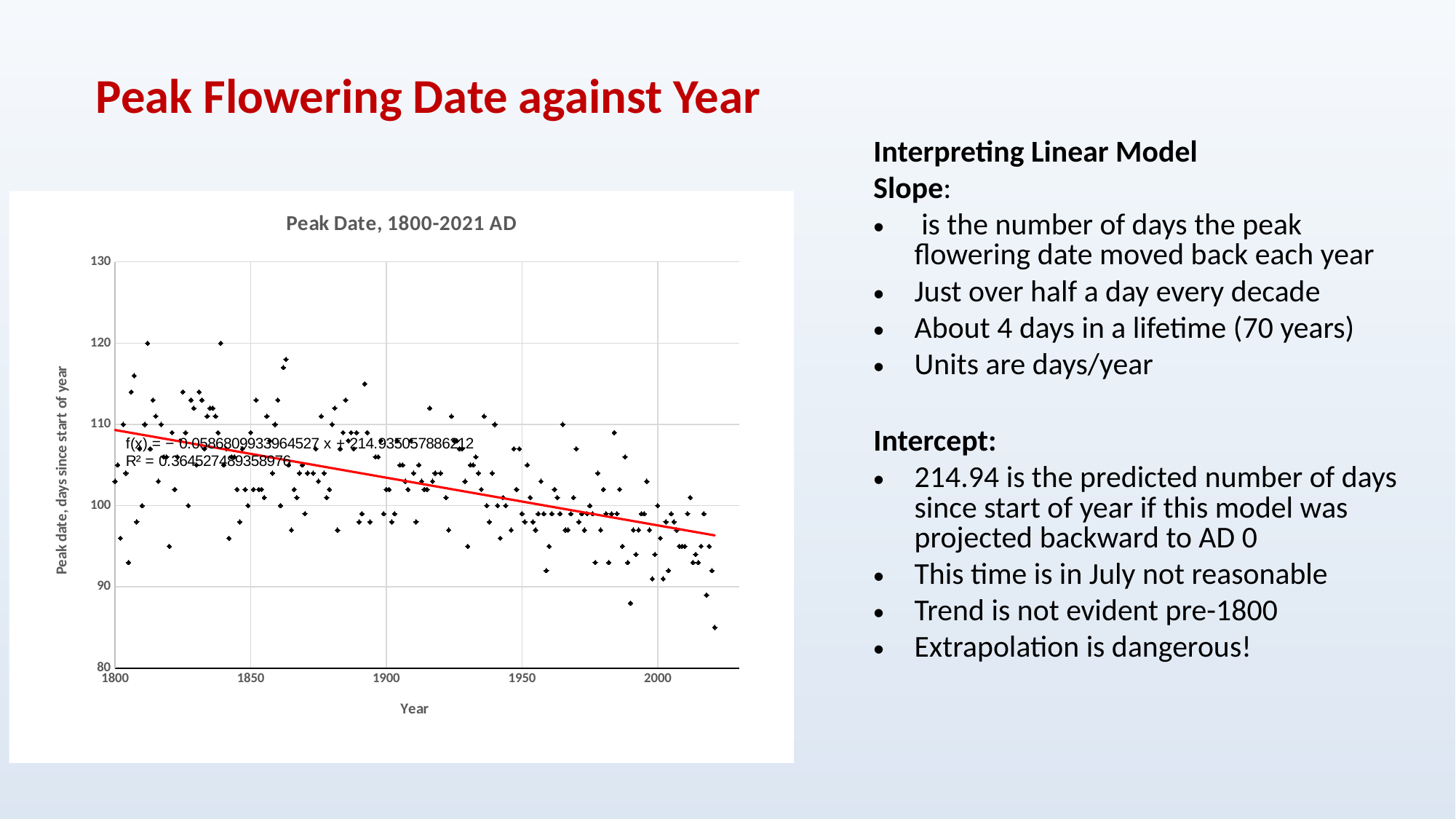
What is the title of the chart? Peak Date, 1800-2021 AD Is the fitted line's value at the year 1800 greater or less than 100 days? greater What is the slope of the fitted line f(x) printed on the chart? −0.0586809933964527 What is the intercept of the fitted line f(x) printed on the chart? 214.935057886212 What kind of chart is shown on the slide? Scatter chart Is the lowest data point on the chart, near the year 2020, greater or less than 90 days? less Do the peak date values generally rise or fall as the year increases from 1800 to 2021? Fall What is the highest value shown on the vertical axis of the chart? 130 Is the highest data point on the chart greater or less than 110 days? greater What colour is the fitted trend line on the chart? Red What is the R² value printed on the chart for the fitted line? 0.364527489358976